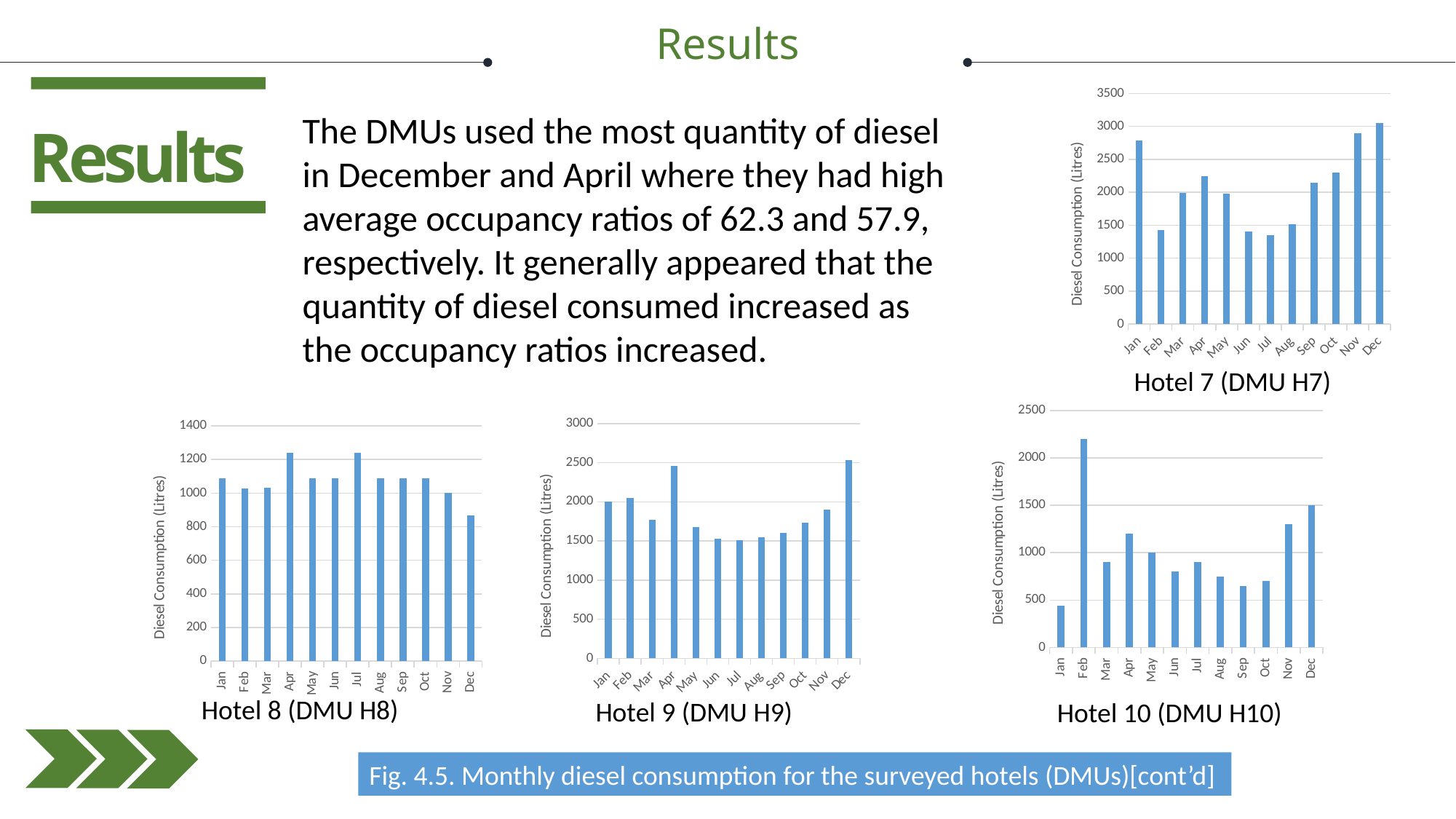
What is the y-axis label of the Hotel 8 (DMU H8) chart? Diesel Consumption (Litres) In the Hotel 9 (DMU H9) chart, which is larger, the value for Apr or the value for May? Apr In the Hotel 9 (DMU H9) chart, is the value for Apr greater or less than 2000? greater In the Hotel 7 (DMU H7) chart, is the value for Feb greater or less than 1500? less In the Hotel 7 (DMU H7) chart, is the value for Jan greater or less than 2500? greater In the Hotel 7 (DMU H7) chart, which month has the highest diesel consumption? Dec How many months are plotted in the Hotel 10 (DMU H10) chart? 12 In the Hotel 8 (DMU H8) chart, which month has the lowest diesel consumption? Dec In the Hotel 10 (DMU H10) chart, which month has the highest diesel consumption? Feb In the Hotel 10 (DMU H10) chart, which month has the lowest diesel consumption? Jan What kind of chart is used for Hotel 7 (DMU H7)? bar chart